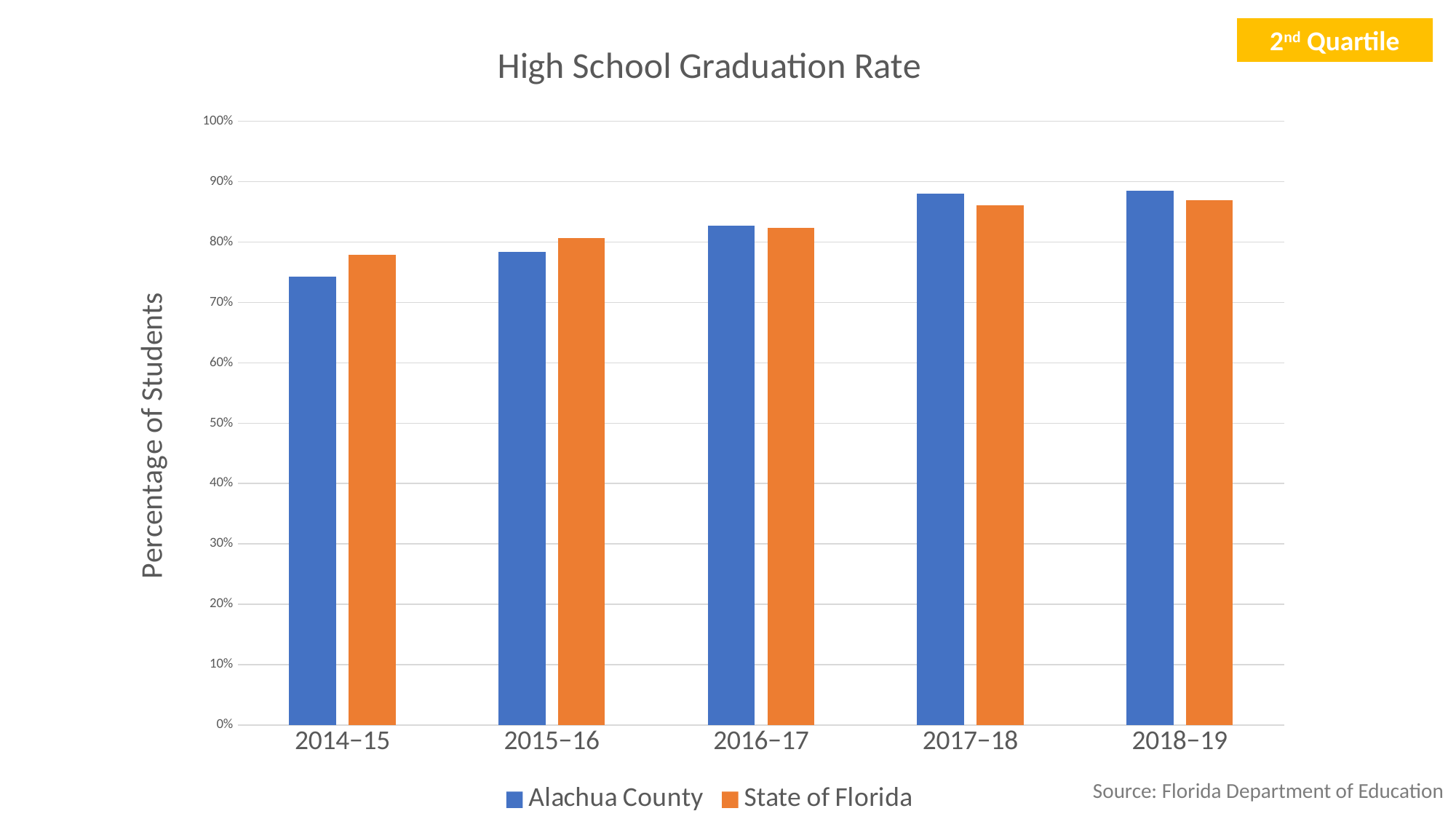
How many series does the legend list? 2 What kind of chart is shown on the slide? bar chart Is the State of Florida value for 2017–18 greater or less than 80%? greater How many school years are shown on the x axis? 5 Is the Alachua County value for 2018–19 greater or less than 90%? less In 2014–15, which is larger: the Alachua County rate or the State of Florida rate? State of Florida What is the title of the chart? High School Graduation Rate Do the Alachua County graduation rates rise or fall from 2014–15 to 2018–19? rise Is the Alachua County value for 2014–15 greater or less than 80%? less Which school year has the lowest graduation rate for Alachua County? 2014–15 In 2017–18, which is larger: the Alachua County rate or the State of Florida rate? Alachua County Which school year has the lowest graduation rate for the State of Florida? 2014–15